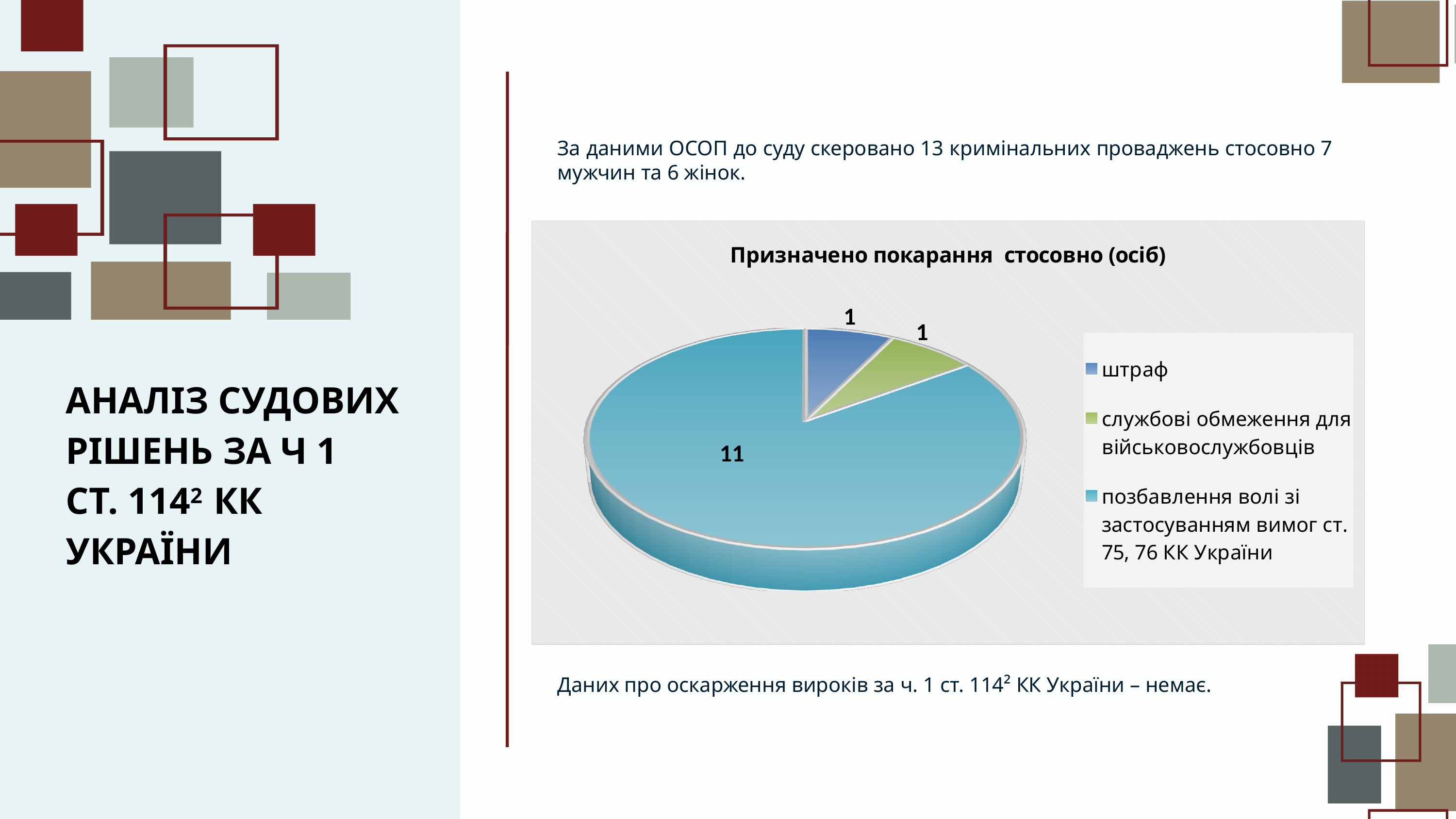
Which category has the largest slice of the pie? позбавлення волі зі застосуванням вимог ст. 75, 76 КК України What is the value for штраф? 1 What is the title of the chart? Призначено покарання стосовно (осіб) What is the value for позбавлення волі зі застосуванням вимог ст. 75, 76 КК України? 11 What is the total of all slices in the pie chart? 13 What type of chart is shown on the slide? pie chart How many entries does the chart legend list? 3 How many slices does the pie chart have? 3 Which is larger: the value for штраф or the value for позбавлення волі зі застосуванням вимог ст. 75, 76 КК України? позбавлення волі зі застосуванням вимог ст. 75, 76 КК України What is the difference between the value for позбавлення волі зі застосуванням вимог ст. 75, 76 КК України and the value for штраф? 10 What colour is the slice for штраф? blue What is the value for службові обмеження для військовослужбовців? 1